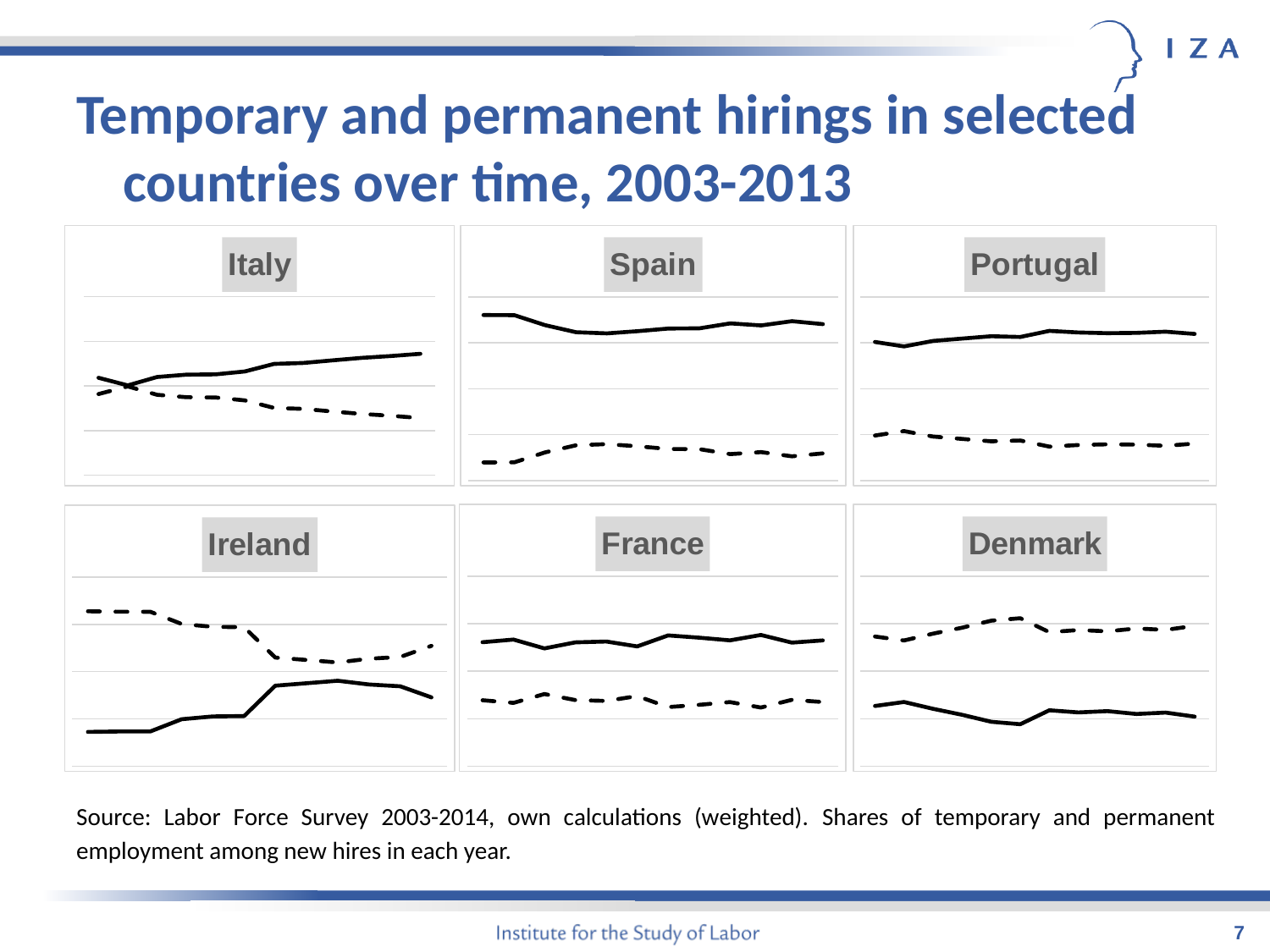
In the Ireland chart, does the dashed line rise or fall overall from left to right? Fall In the Ireland chart, is the solid line higher at the right end than at the left end? Yes In the Ireland chart, which line is higher throughout, the solid line or the dashed line? Dashed line Which country's chart is in the top-right position on the slide? Portugal In the Spain chart, which line is higher throughout, the solid line or the dashed line? Solid line In the Italy chart, does the solid line rise or fall from left to right? Rise How many country charts are shown on the slide? 6 In the France chart, which line is higher, the solid line or the dashed line? Solid line How many lines are plotted in the Spain chart? 2 What kind of chart is used for each country panel on the slide? Line chart